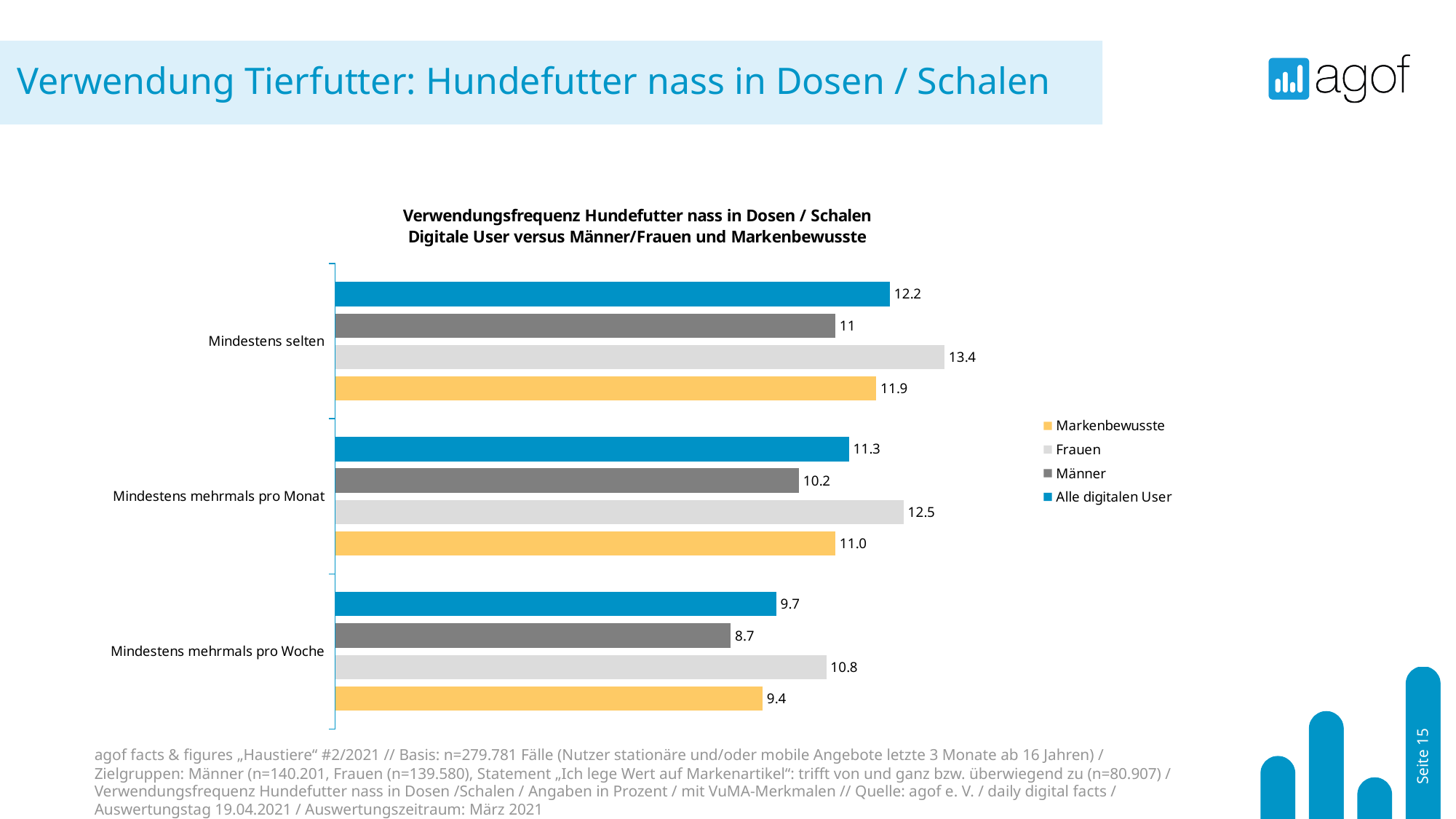
How many categories are shown on the chart? 3 How many series does the legend list? 4 What kind of chart is shown on the slide? Bar chart Which series has the highest value in the "Mindestens selten" category? Frauen Which series has the lowest value in the "Mindestens mehrmals pro Monat" category? Männer What is the value for Alle digitalen User in the "Mindestens mehrmals pro Woche" category? 9.7 What is the value for Markenbewusste in the "Mindestens mehrmals pro Monat" category? 11.0 In the "Mindestens selten" category, which is larger: the value for Alle digitalen User or the value for Markenbewusste? Alle digitalen User What is the value for Männer in the "Mindestens mehrmals pro Woche" category? 8.7 Which colour represents the Markenbewusste series in the chart? Yellow What is the value for Frauen in the "Mindestens selten" category? 13.4 What is the difference between the Frauen and Männer values in the "Mindestens mehrmals pro Woche" category? 2.1